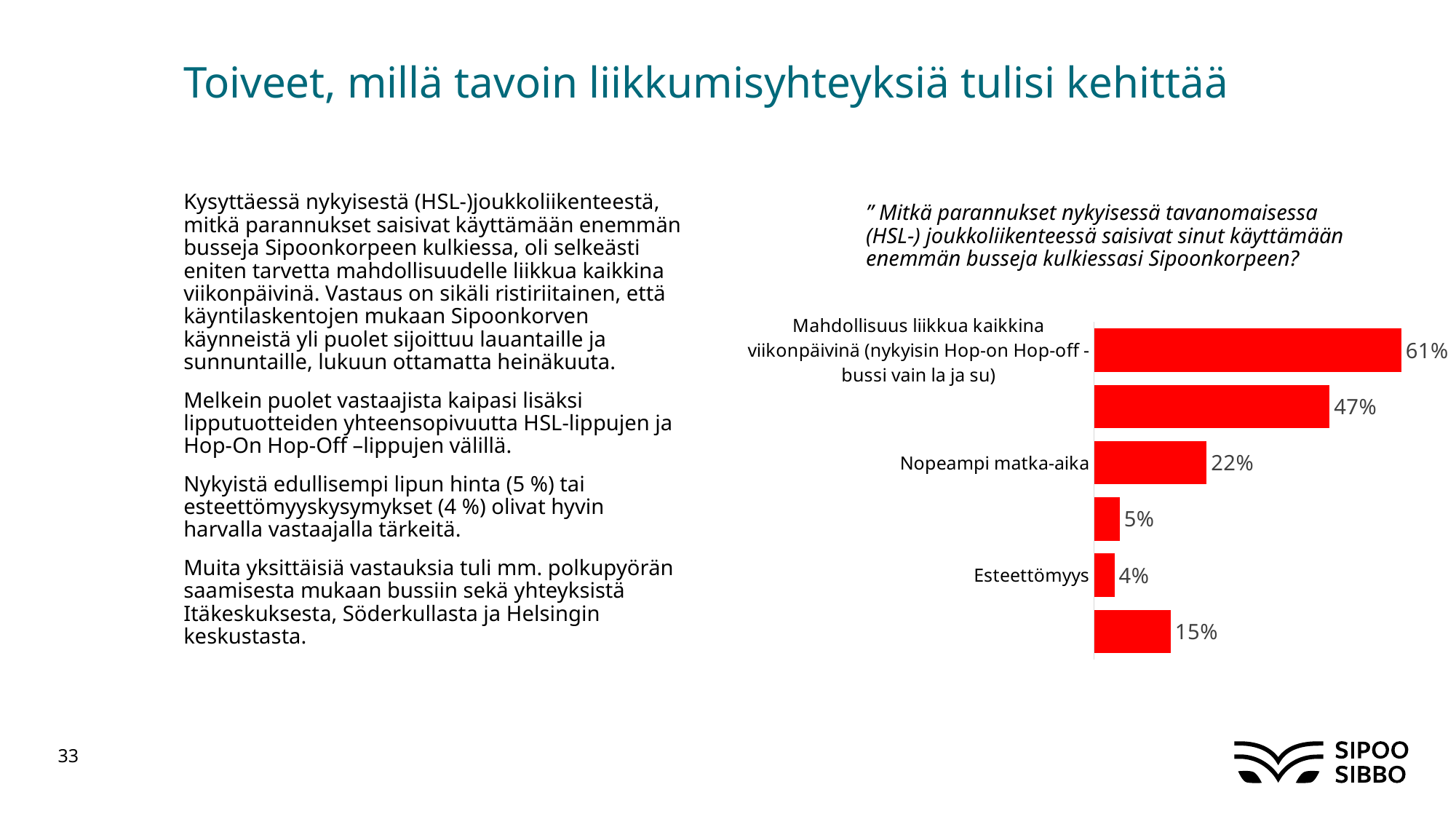
What is the highest value shown as a data label in the chart? 61% What is the difference between the highest value and the value for "Nopeampi matka-aika"? 39% Which is larger, the value for "Nopeampi matka-aika" or the value for "Esteettömyys"? Nopeampi matka-aika What is the value for "Mahdollisuus liikkua kaikkina viikonpäivinä (nykyisin Hop-on Hop-off -bussi vain la ja su)"? 61% What is the difference between the values for "Nopeampi matka-aika" and "Esteettömyys"? 18% Which category has the lowest value in the chart? Esteettömyys Which category has the highest value in the chart? Mahdollisuus liikkua kaikkina viikonpäivinä (nykyisin Hop-on Hop-off -bussi vain la ja su) What is the value for "Nopeampi matka-aika"? 22% What is the value for "Esteettömyys"? 4% What colour are the bars in the chart? red How many bars are plotted in the chart? 6 What kind of chart is shown on the slide? bar chart